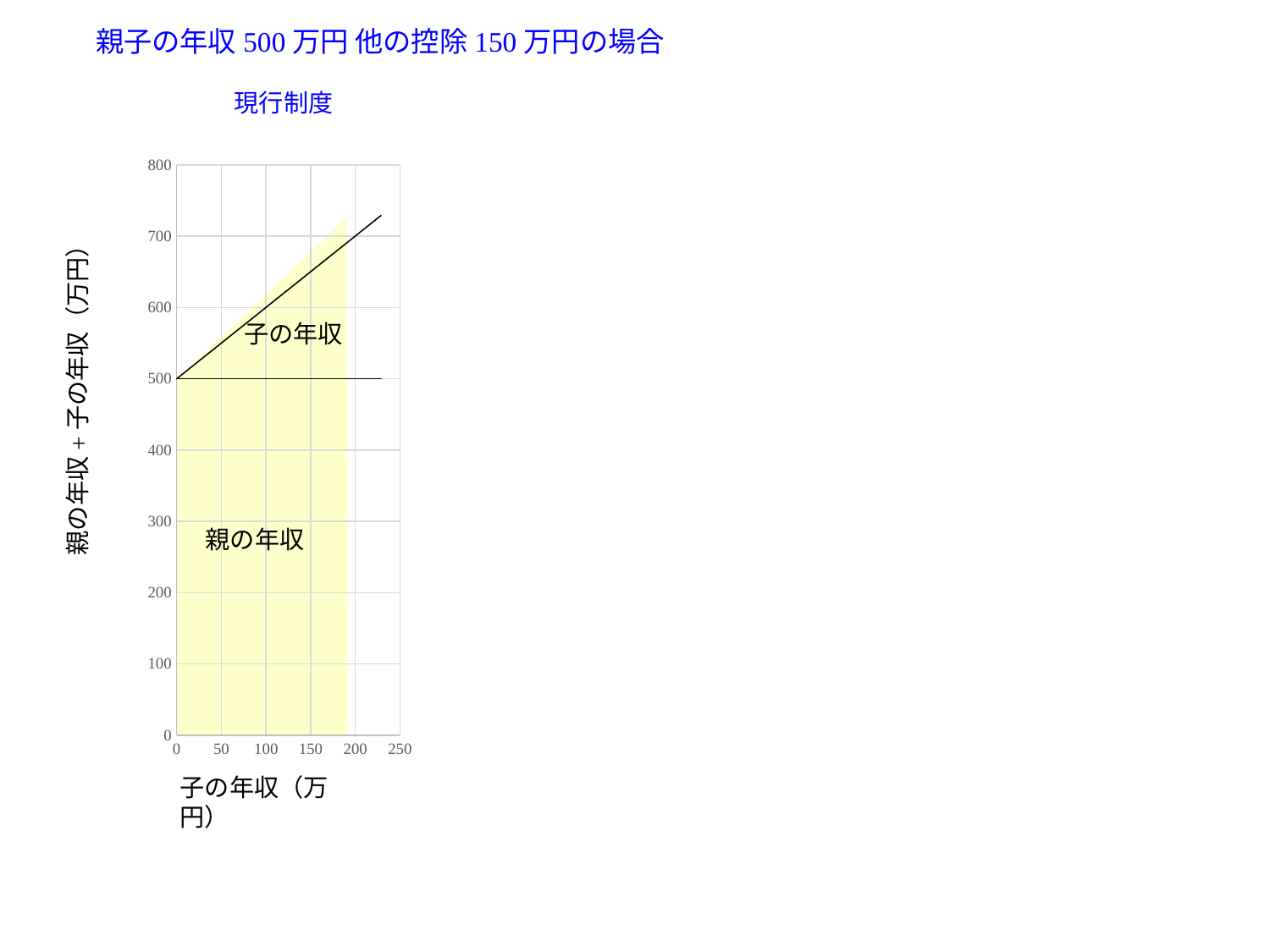
How many lines are plotted on the chart? 2 Is the value of the upper line at 子の年収 = 200 greater or less than 800? less What is the value of the upper line at 子の年収 = 0? 500 Does the upper line (子の年収) rise or fall as 子の年収 increases along the x axis? rise Is the value of the upper line at 子の年収 = 100 greater or less than 500? greater Is the value of the upper line at 子の年収 = 150 greater or less than 600? greater At what value on the y axis does the horizontal line (親の年収) sit? 500 What is the highest value shown on the y axis? 800 What kind of chart is shown on the slide? line chart What is the label of the x axis? 子の年収（万円） What is the title of the chart? 現行制度 Which is larger at 子の年収 = 150: the upper line (子の年収) or the horizontal line (親の年収)? the upper line (子の年収)